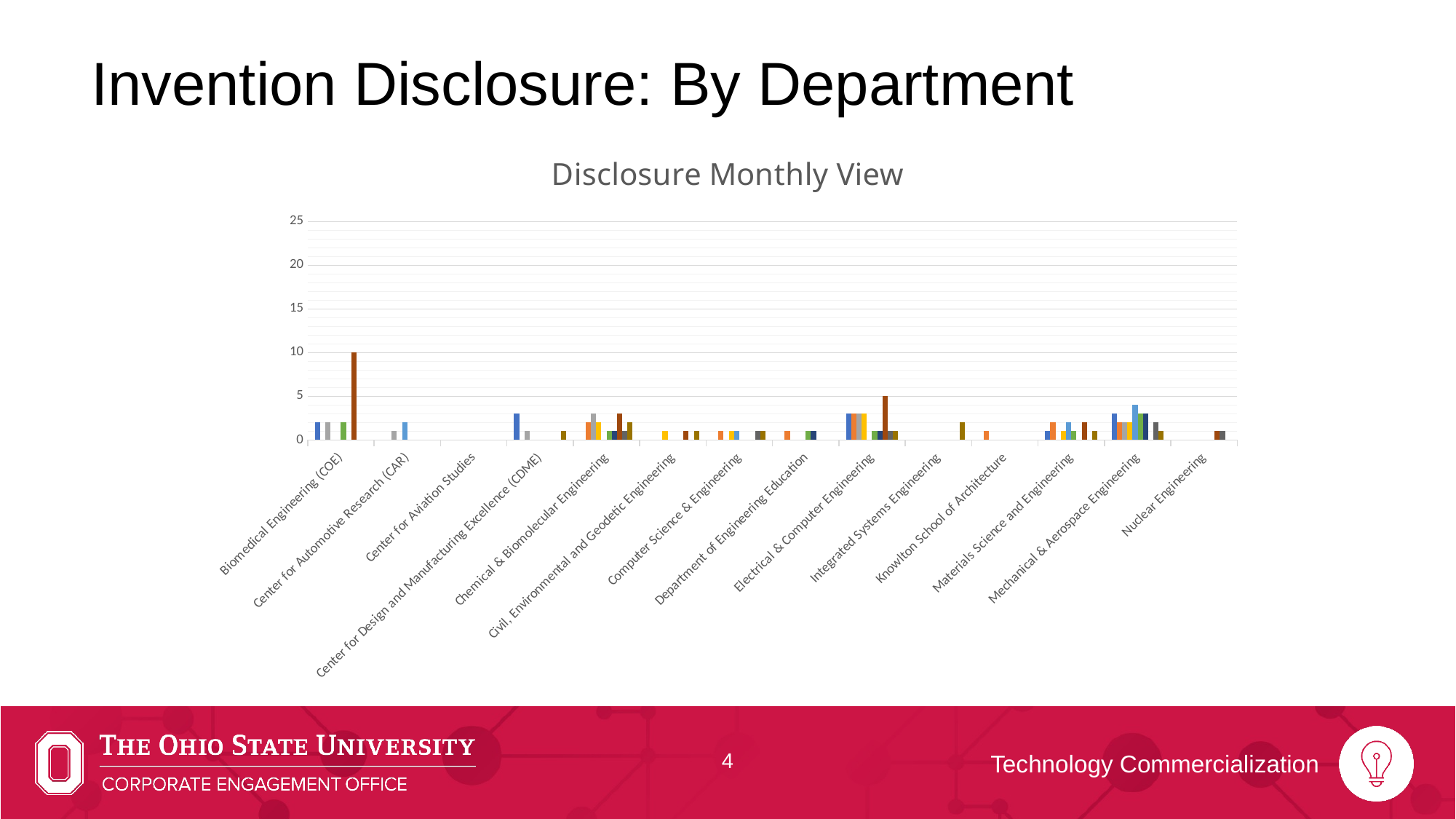
What is the highest value shown on the y axis of the chart? 25 Which has a taller maximum bar: Biomedical Engineering (COE) or Electrical & Computer Engineering? Biomedical Engineering (COE) What kind of chart is shown on the slide? bar chart What is the difference between the tallest bar for Biomedical Engineering (COE) and the tallest bar for Electrical & Computer Engineering? 5 What value does the tallest bar for Biomedical Engineering (COE) reach? 10 How many departments are listed along the x axis of the chart? 14 Is the tallest bar for Mechanical & Aerospace Engineering greater or less than 5? less What is the title of the chart? Disclosure Monthly View Is the tallest bar for Biomedical Engineering (COE) greater or less than 5? greater Which department shows no bars at all in the chart? Center for Aviation Studies What value does the tallest bar for Electrical & Computer Engineering reach? 5 Which department has the tallest bar in the chart? Biomedical Engineering (COE)